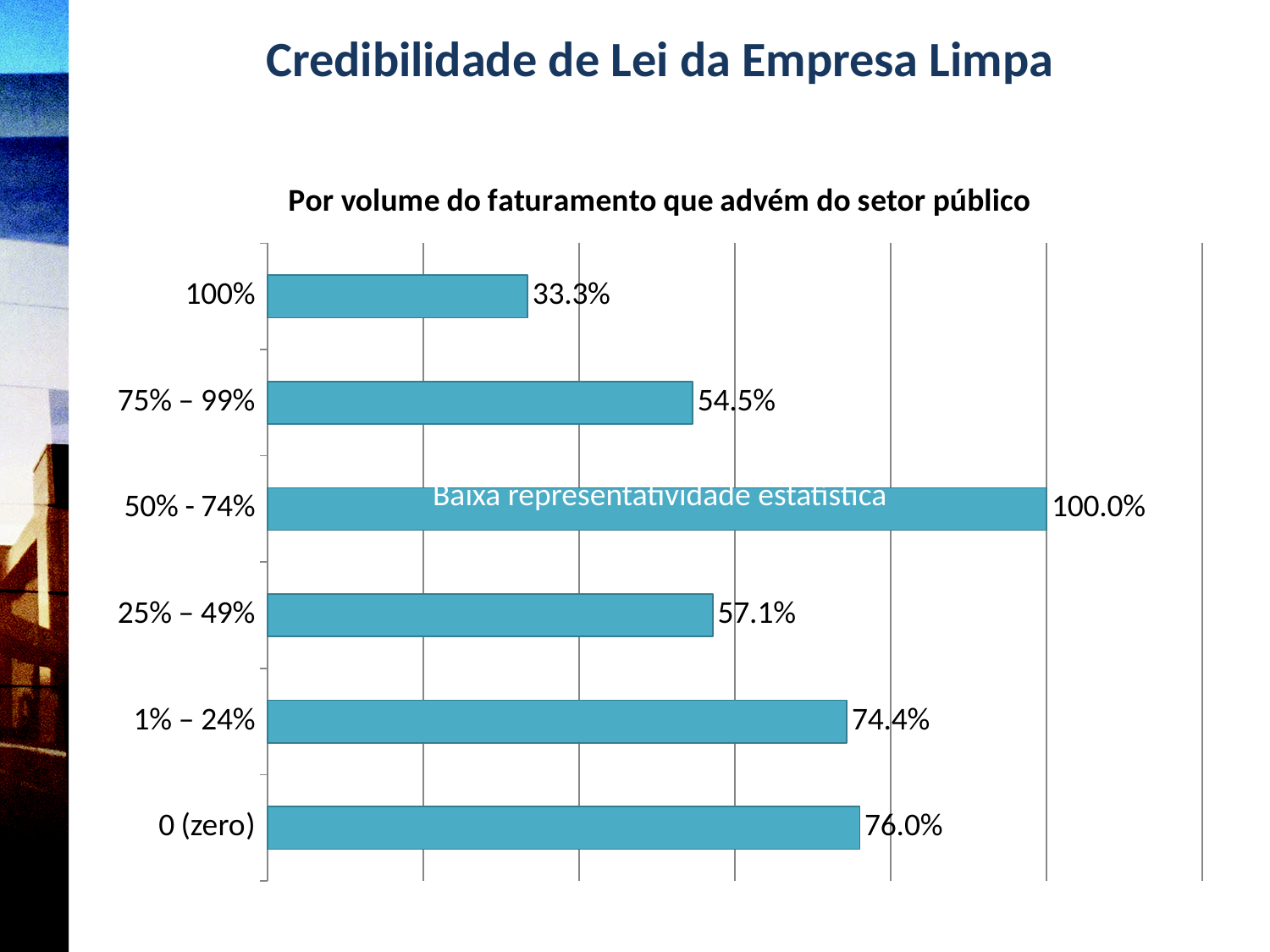
Which category has the lowest value? 100% What is the difference between the values for "0 (zero)" and "1% – 24%"? 1.6% Which is larger, the value for "25% – 49%" or the value for "75% – 99%"? 25% – 49% How many categories are shown in the chart? 6 What kind of chart is shown on the slide? Bar chart What is the value for the "50% - 74%" category? 100.0% What is the title of the chart? Por volume do faturamento que advém do setor público Which category has the highest value? 50% - 74% What is the value for the "100%" category? 33.3% What is the value for the "0 (zero)" category? 76.0% What is the value for the "1% – 24%" category? 74.4% What is the difference between the values for "75% – 99%" and "100%"? 21.2%